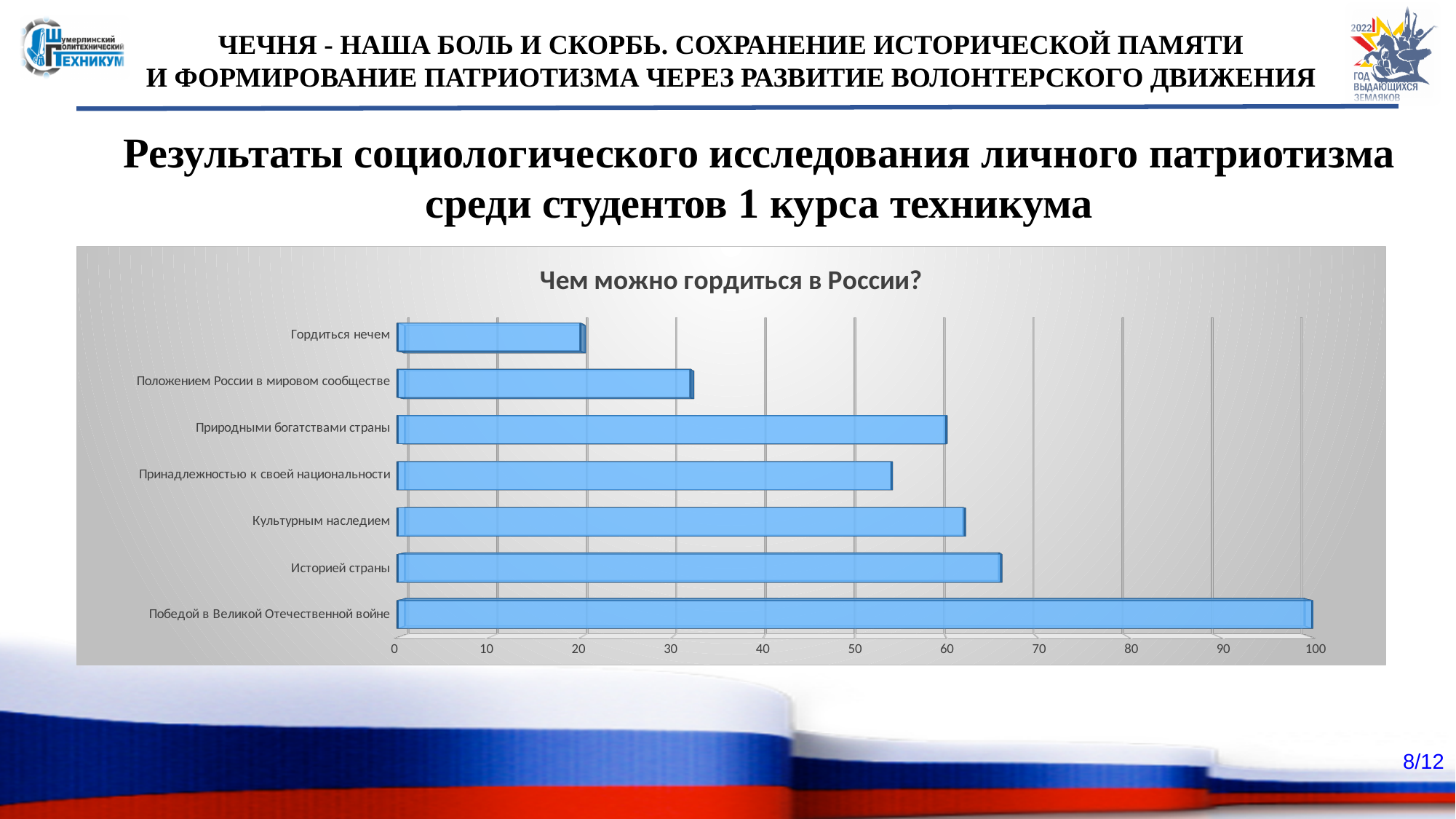
What kind of chart is shown on the slide? bar chart Which is larger: the value for Историей страны or the value for Принадлежностью к своей национальности? Историей страны Is the value for Гордиться нечем greater or less than 30? less Is the value for Принадлежностью к своей национальности greater or less than 60? less Is the value for Победой в Великой Отечественной войне greater or less than 90? greater What is the title of the chart? Чем можно гордиться в России? Which category has the highest value? Победой в Великой Отечественной войне Which is larger: the value for Природными богатствами страны or the value for Положением России в мировом сообществе? Природными богатствами страны How many categories are plotted in the chart? 7 Which category has the lowest value? Гордиться нечем